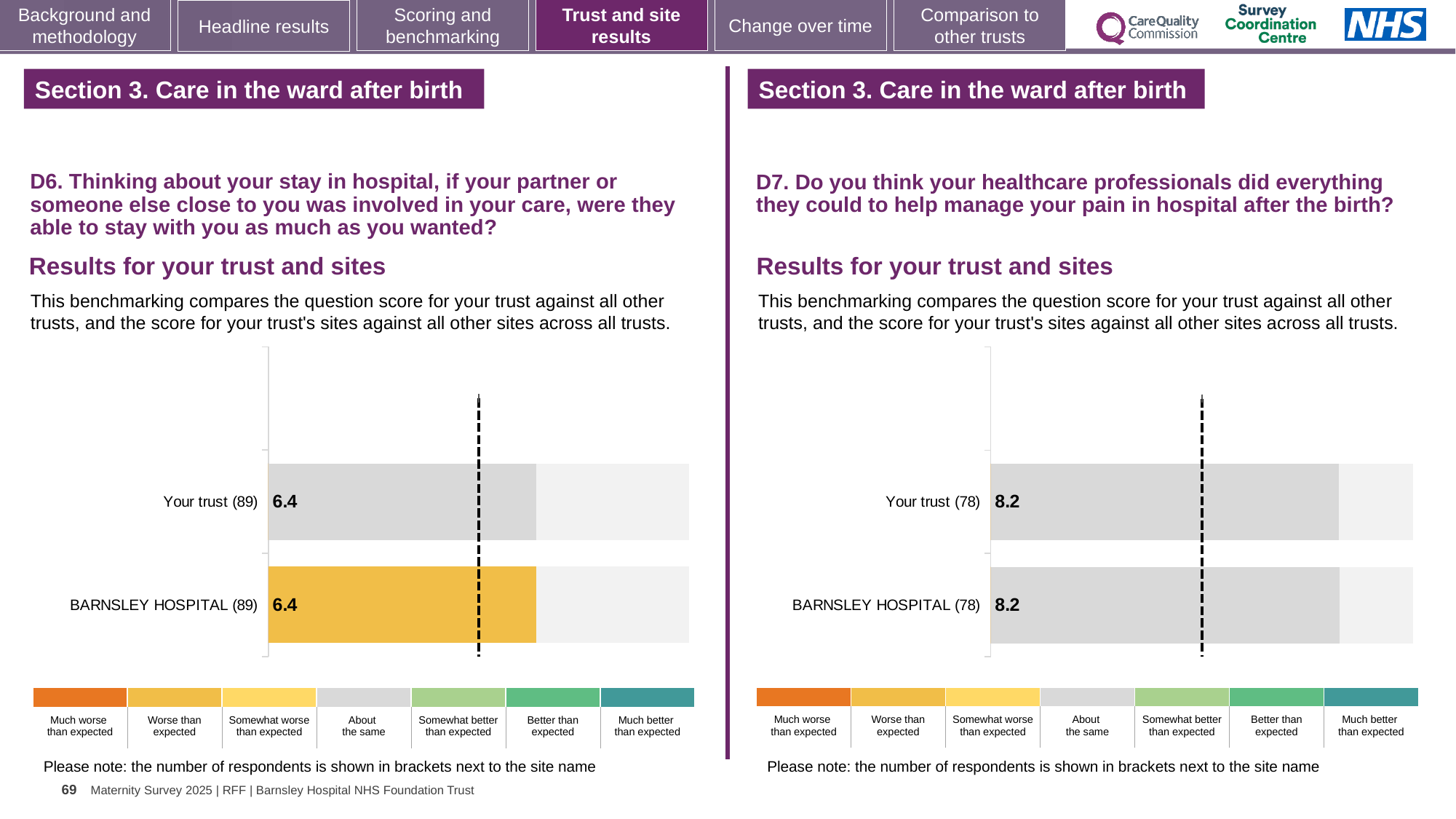
On the right chart (D7), how many respondents are shown in brackets next to Your trust? 78 On the right chart (D7), what is the score for BARNSLEY HOSPITAL? 8.2 On the left chart (D6), what is the difference between the score for Your trust and the score for BARNSLEY HOSPITAL? 0.0 On the right chart (D7), what is the score for Your trust? 8.2 What kind of chart is used on the left (D6)? Bar chart On the left chart (D6), what is the score for Your trust? 6.4 On the left chart (D6), what is the score for BARNSLEY HOSPITAL? 6.4 On the left chart (D6), how many respondents are shown in brackets next to BARNSLEY HOSPITAL? 89 How many bars are plotted on the right chart (D7)? 2 How many bars are plotted on the left chart (D6)? 2 On the right chart (D7), what is the difference between the score for Your trust and the score for BARNSLEY HOSPITAL? 0.0 On the left chart (D6), which benchmark category does the colour of the BARNSLEY HOSPITAL bar correspond to in the legend? Worse than expected